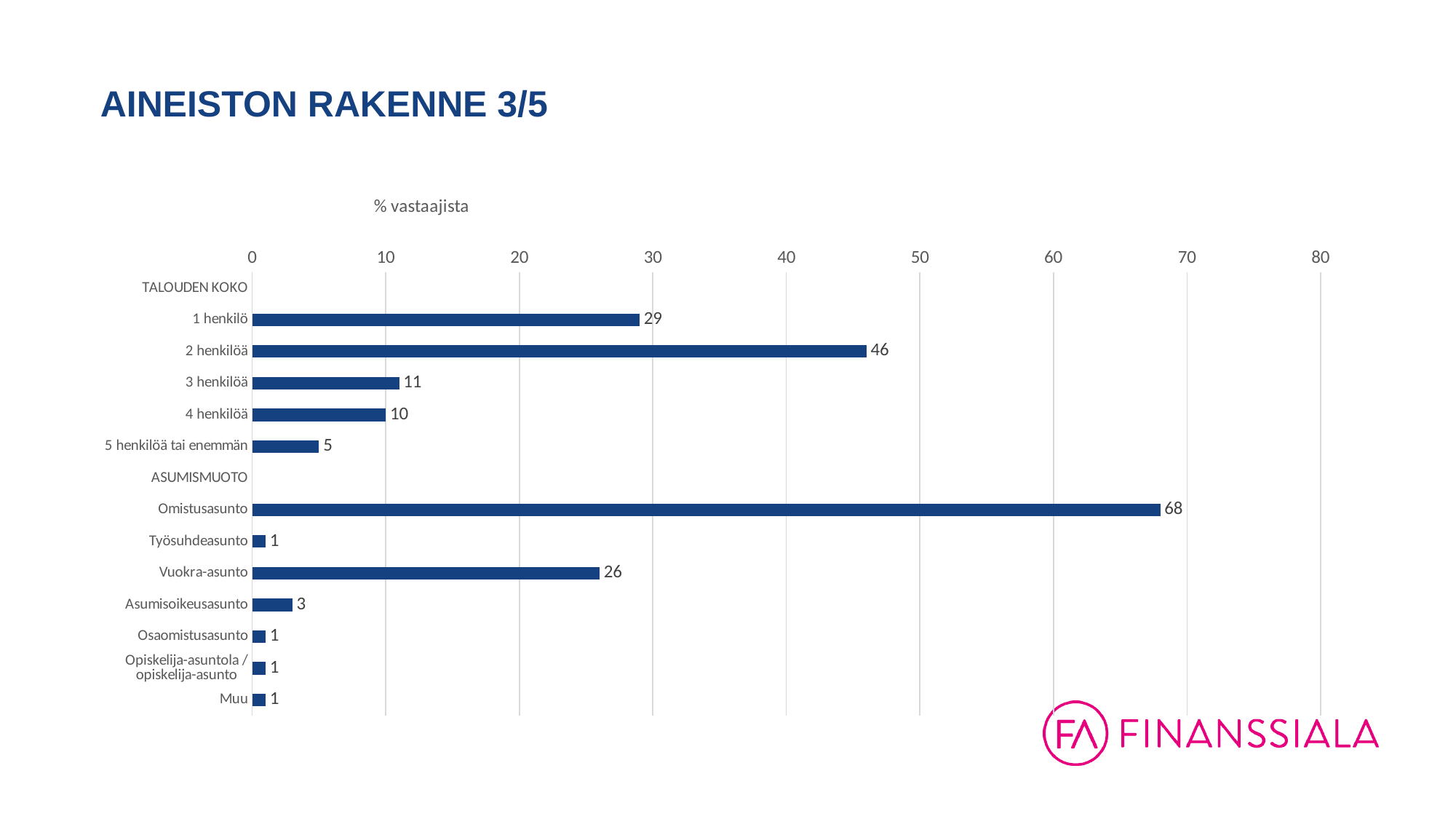
What is the value for 2 henkilöä? 46 What is the value for 5 henkilöä tai enemmän? 5 Is the value for Omistusasunto greater or less than 60? greater Which category has the highest value on the chart? Omistusasunto What is the difference between the values for 2 henkilöä and 1 henkilö? 17 What is the value for Omistusasunto? 68 What is the difference between the values for Omistusasunto and Vuokra-asunto? 42 Which is larger, the value for 3 henkilöä or the value for 4 henkilöä? 3 henkilöä What is the axis label shown above the chart? % vastaajista What kind of chart is shown on the slide? bar chart What is the value for Vuokra-asunto? 26 Among the TALOUDEN KOKO categories, which has the lowest value? 5 henkilöä tai enemmän